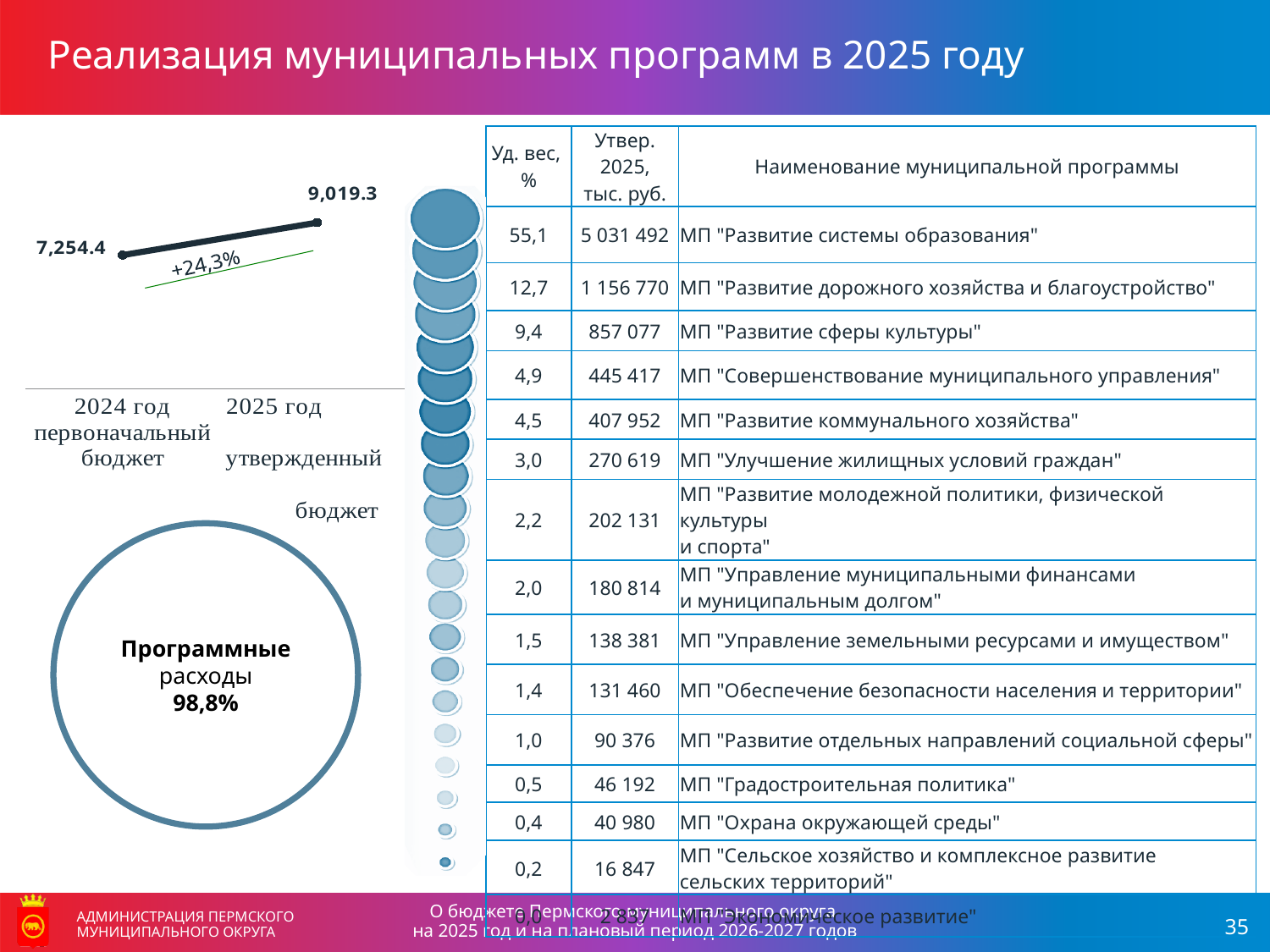
What share of expenditures is shown as programme expenditures (Программные расходы) in the circle on the left? 98,8% What kind of chart is shown at the top left of the slide? line chart On the line chart at the top left, what is the difference between the 2025 approved budget and the 2024 initial budget? 1,764.9 On the line chart at the top left, what is the value for the 2024 initial budget (2024 год первоначальный бюджет)? 7,254.4 On the line chart at the top left, what is the value for the 2025 approved budget (2025 год утвержденный бюджет)? 9,019.3 In the bubble chart next to the table, what share (Уд. вес, %) corresponds to МП "Развитие сферы культуры"? 9,4 On the line chart at the top left, what percentage change is shown between the 2024 initial budget and the 2025 approved budget? +24,3% On the line chart at the top left, which of the two points is higher: 2024 год первоначальный бюджет or 2025 год утвержденный бюджет? 2025 год утвержденный бюджет In the bubble chart next to the table, what share (Уд. вес, %) corresponds to the largest bubble, МП "Развитие системы образования"? 55,1 In the bubble chart next to the table, which municipal programme has the largest bubble (highest share)? МП "Развитие системы образования" On the line chart at the top left, does the value rise or fall from 2024 to 2025? rise On the line chart at the top left, how many data points are plotted? 2